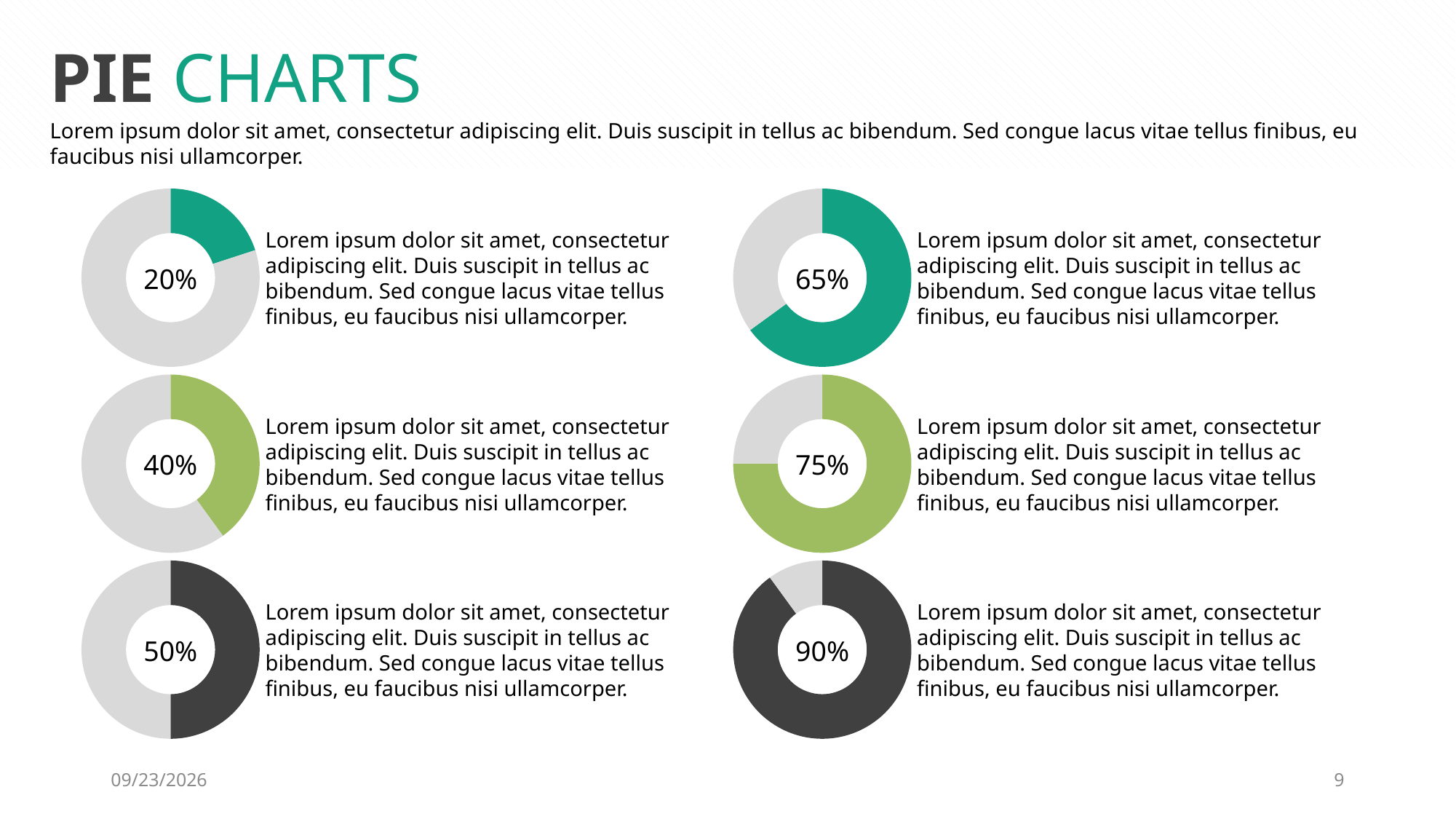
Which donut chart on the slide shows the highest percentage? The bottom-right chart (90%) Which shows a larger percentage, the middle-left donut chart or the top-right donut chart? The top-right chart (65%) What type of chart is used for each of the six figures on the slide? Donut (pie) chart What percentage is shown in the centre of the middle-left donut chart? 40% What is the difference between the percentage in the bottom-right donut chart and the percentage in the top-left donut chart? 70% Which donut chart on the slide shows the lowest percentage? The top-left chart (20%) What percentage is shown in the centre of the middle-right donut chart? 75% What percentage is shown in the centre of the top-left donut chart? 20% What percentage is shown in the centre of the bottom-left donut chart? 50% What percentage is shown in the centre of the top-right donut chart? 65% How many donut charts are shown on the slide? 6 What percentage is shown in the centre of the bottom-right donut chart? 90%